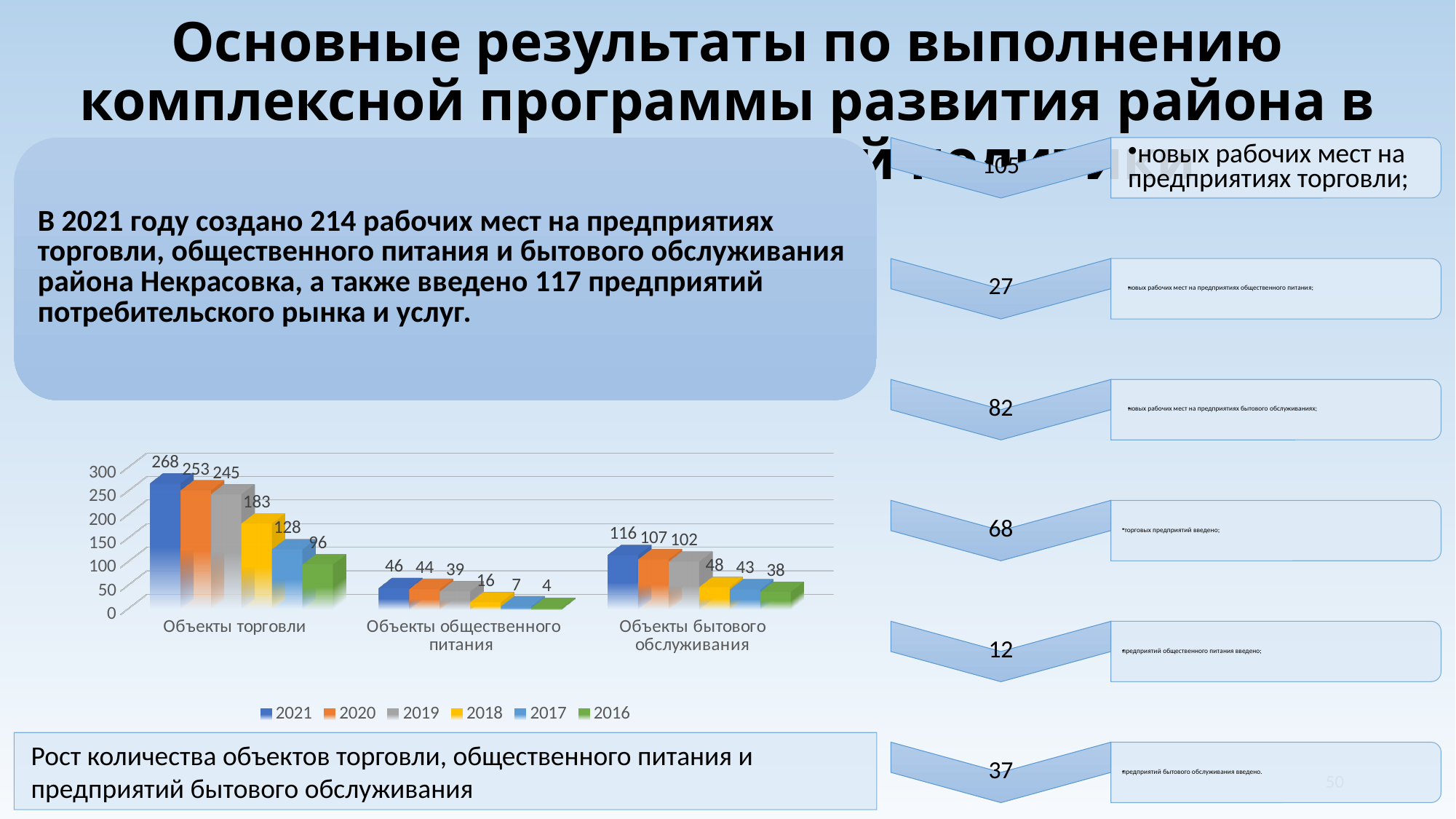
What is the value for 2016 in the category Объекты общественного питания? 4 Which is larger: the 2017 value for Объекты бытового обслуживания or the 2017 value for Объекты общественного питания? Объекты бытового обслуживания Which category has the highest value for 2021? Объекты торговли What type of chart is shown on the slide? bar chart What is the difference between the 2021 and 2016 values for Объекты торговли? 172 What is the value for 2021 in the category Объекты торговли? 268 Which category has the lowest value for 2018? Объекты общественного питания Within the category Объекты торговли, do the values rise or fall going from 2021 to 2016 in the legend order? fall How many series does the chart legend list? 6 What is the value for 2019 in the category Объекты бытового обслуживания? 102 Which colour represents the 2018 series in the chart legend? yellow How many categories are shown on the x axis of the chart? 3